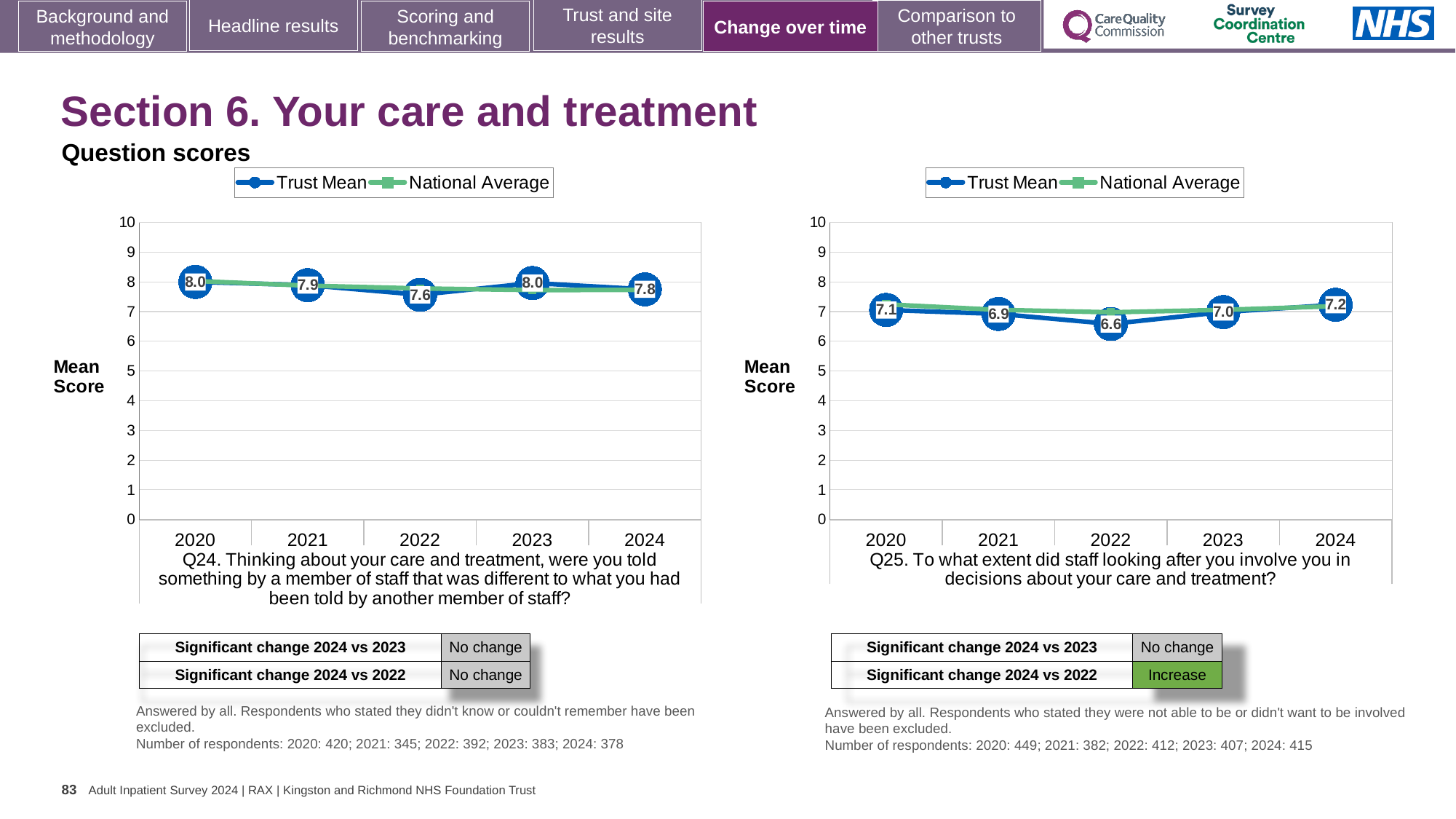
In the Q24 chart on the left, is the National Average value for 2020 greater or less than 7? greater In the Q24 chart on the left, what is the difference between the Trust Mean scores for 2023 and 2022? 0.4 In the Q25 chart on the right, which year has the lowest Trust Mean score? 2022 How many years are plotted on the x axis of the Q25 chart on the right? 5 In the Q24 chart on the left, which year has the lowest Trust Mean score? 2022 In the Q24 chart on the left, what is the Trust Mean score for 2022? 7.6 In the Q25 chart on the right, which year has the highest Trust Mean score? 2024 In the Q25 chart on the right, what is the Trust Mean score for 2024? 7.2 In the Q24 chart on the left, is the Trust Mean score higher in 2021 or in 2022? 2021 In the Q25 chart on the right, what is the difference between the Trust Mean scores for 2024 and 2022? 0.6 How many series does the legend of the Q24 chart on the left list? 2 What type of chart is the Q25 chart on the right? Line chart